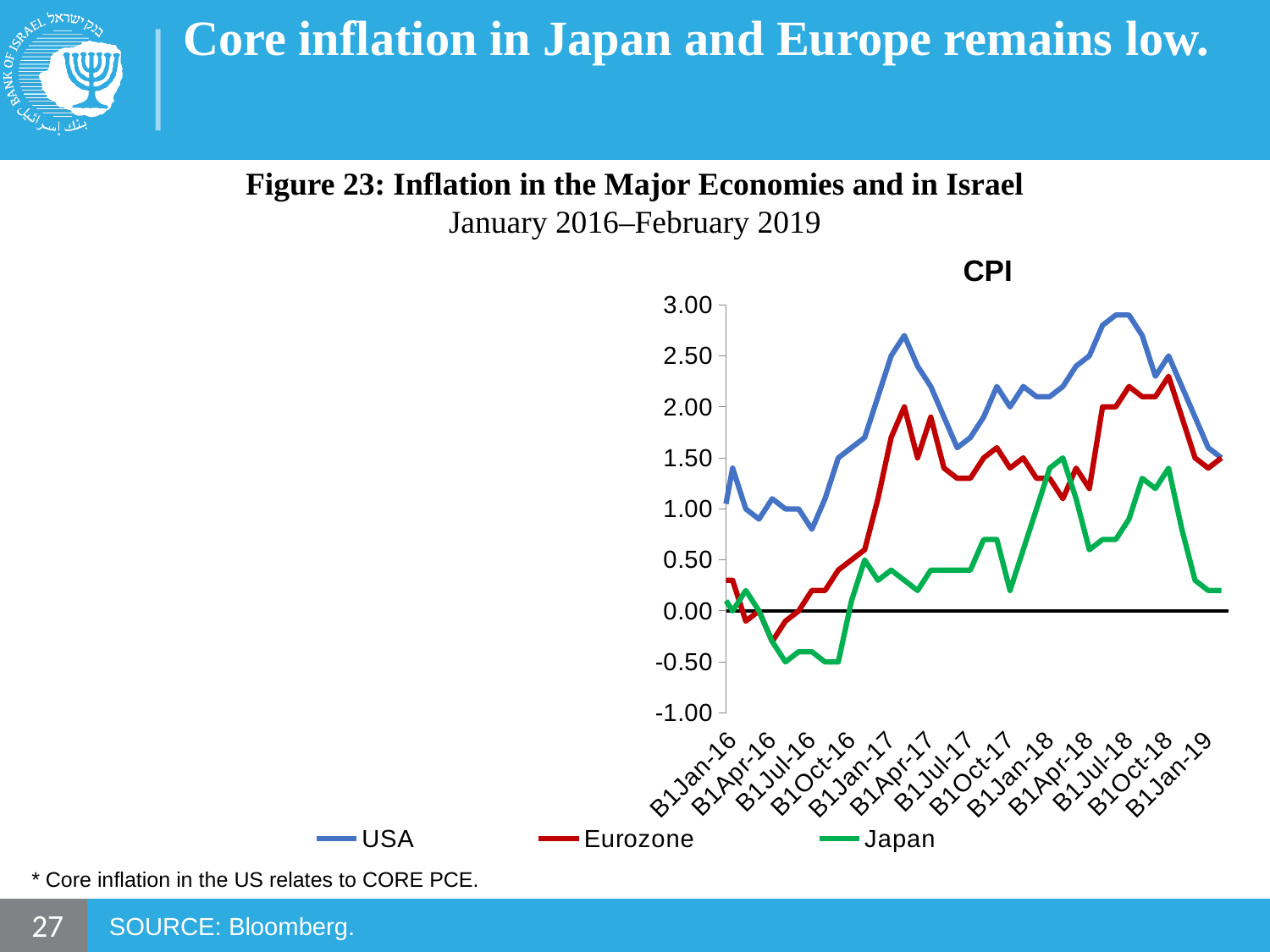
Is the lowest value of the Japan line in 2016 greater or less than 0.00? less Which series has the highest value at the start of the period (January 2016)? USA Is the value of the Eurozone line at the start of the period (January 2016) greater or less than 1.00? less Which series has the lowest value around July 2016? Japan What are the series listed in the legend? USA, Eurozone, Japan Is the peak value of the USA line in 2018 greater or less than 2.50? greater Does the USA line rise or fall between July 2018 and January 2019? Fall What is the title printed above the chart? CPI Around July 2018, which is higher: the USA line or the Japan line? USA How many series does the legend list? 3 What kind of chart is shown on the slide? Line chart